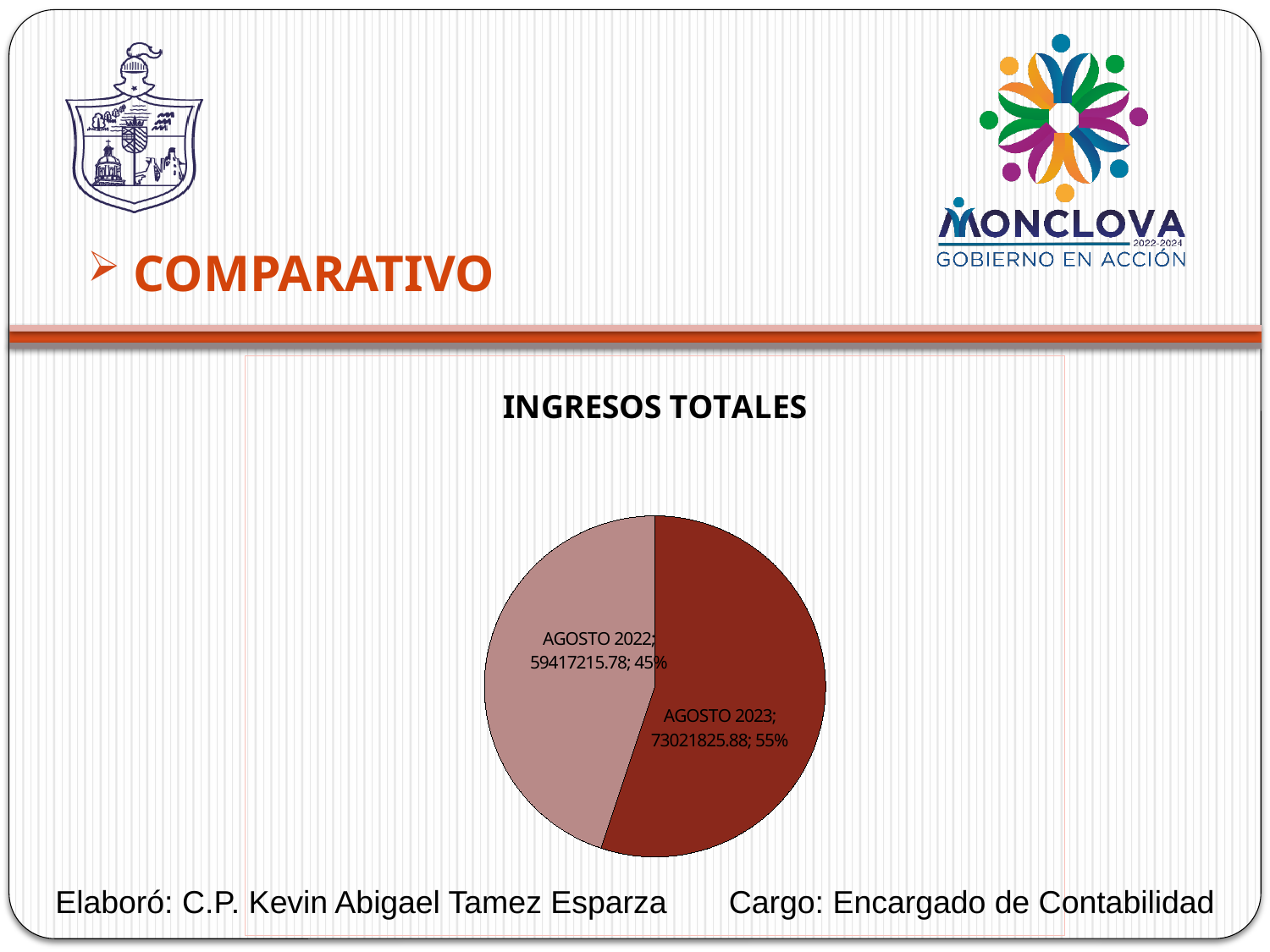
What type of chart is shown under the title INGRESOS TOTALES? pie chart What share of the pie does AGOSTO 2022 represent? 45% Which slice is the smallest? AGOSTO 2022 What is the value for AGOSTO 2023? 73021825.88 What is the difference between the values for AGOSTO 2023 and AGOSTO 2022? 13604610.10 What is the title of the chart? INGRESOS TOTALES What share of the pie does AGOSTO 2023 represent? 55% How many slices does the pie chart have? 2 Which slice is the largest? AGOSTO 2023 What is the total of the two slices? 132439041.66 What is the value for AGOSTO 2022? 59417215.78 Which is larger, AGOSTO 2022 or AGOSTO 2023? AGOSTO 2023